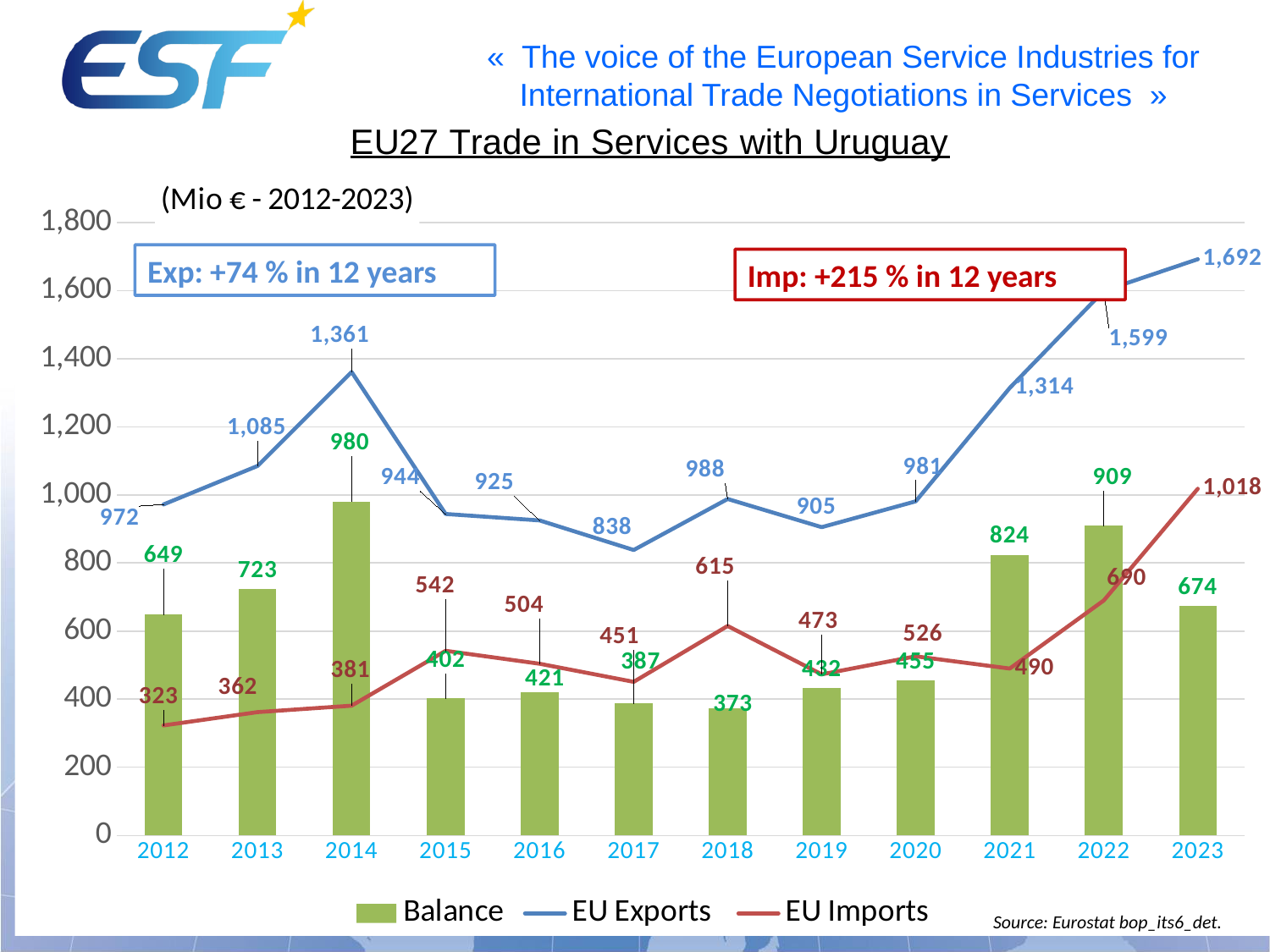
Do EU Exports rise or fall from 2020 to 2023? Rise What is the difference between EU Exports and EU Imports in 2022? 909 Which is larger, EU Exports in 2013 or EU Exports in 2021? EU Exports in 2021 How many series does the legend list? 3 What kind of chart is used for the Balance series? Bar chart What is the Balance value for 2018? 373 What is the value of EU Exports in 2014? 1,361 In which year is EU Imports the lowest? 2012 According to the text box, by what percentage did imports grow in 12 years? +215 % What is the value of EU Imports in 2023? 1,018 In which year is the Balance bar the highest? 2014 How many years are shown on the x axis? 12